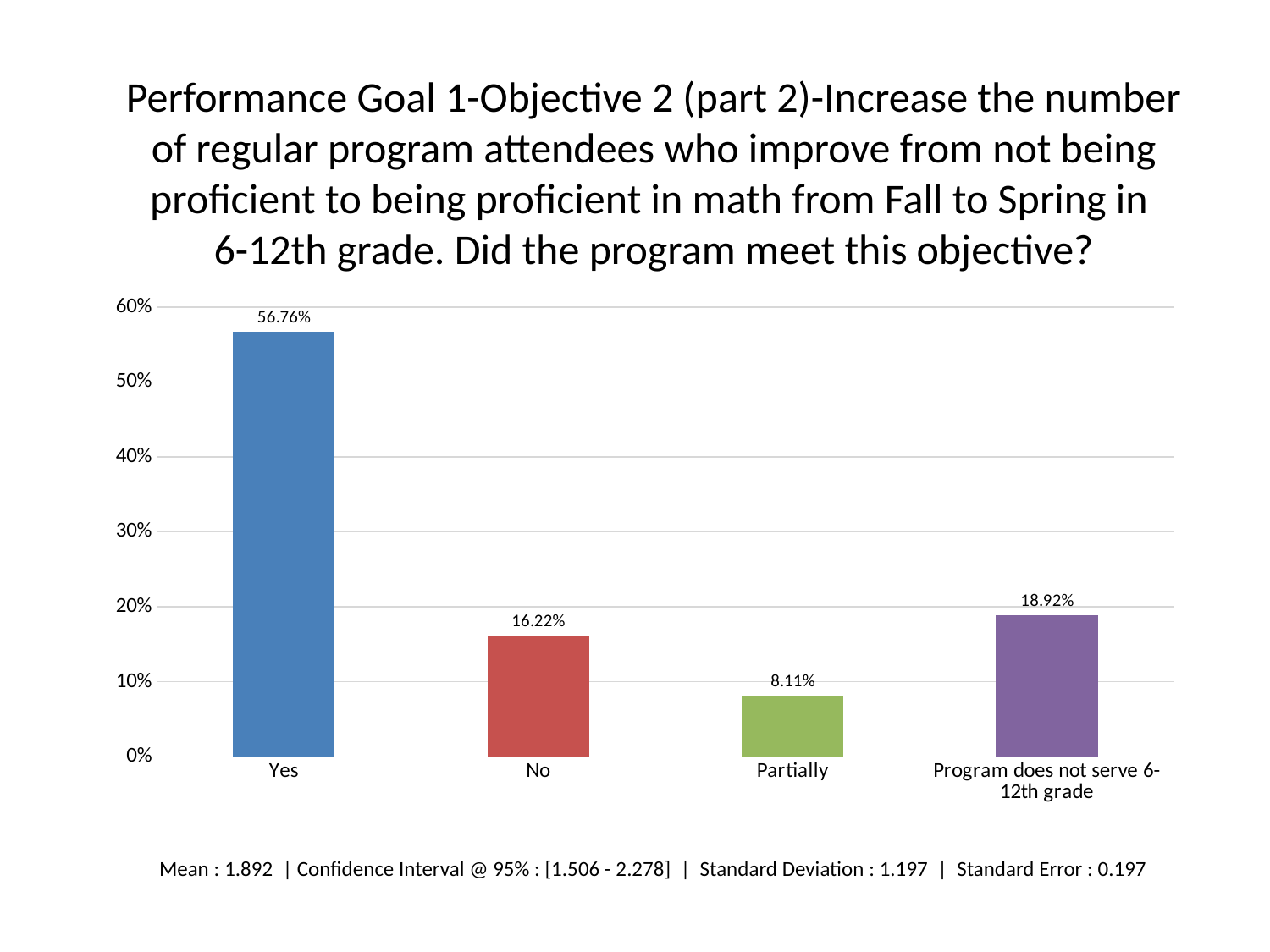
Which is larger, the value for No or the value for Program does not serve 6-12th grade? Program does not serve 6-12th grade What is the value for Partially? 8.11% Which category has the lowest value? Partially What is the value for No? 16.22% What is the difference between the values for Yes and No? 40.54% Is the value for Yes greater or less than 50%? greater What kind of chart is shown on the slide? bar chart What is the value for Program does not serve 6-12th grade? 18.92% What is the difference between the values for Program does not serve 6-12th grade and Partially? 10.81% Which category has the highest value? Yes How many categories are shown on the x axis? 4 What is the value for Yes? 56.76%